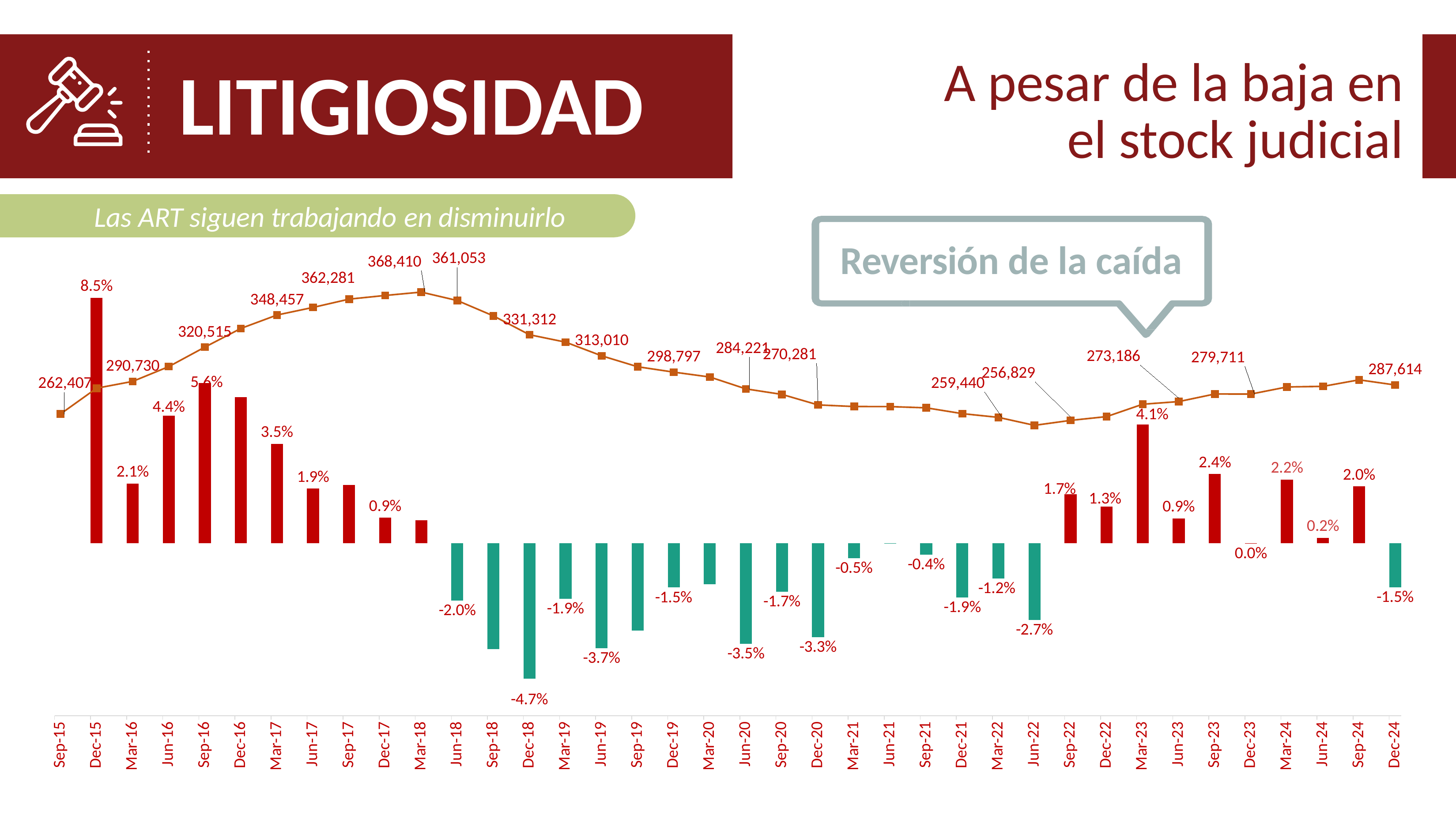
What is the percentage change shown for Mar-23? 4.1% What is the stock value shown on the line for Sep-15? 262,407 Which quarter has the highest bar (percentage change)? Dec-15 What is the highest value labelled on the line? 368,410 Which quarter has the larger percentage change, Jun-16 or Sep-16? Sep-16 What is the percentage change shown for Dec-24? -1.5% Which quarter has the lowest bar (percentage change)? Dec-18 What kind of chart is shown on the slide? A combined bar and line chart What is the difference between the percentage change for Sep-23 and Jun-23? 1.5 percentage points How many quarters are shown on the x axis? 38 What is the percentage change shown for Dec-15? 8.5% What is the percentage change shown for Dec-18? -4.7%